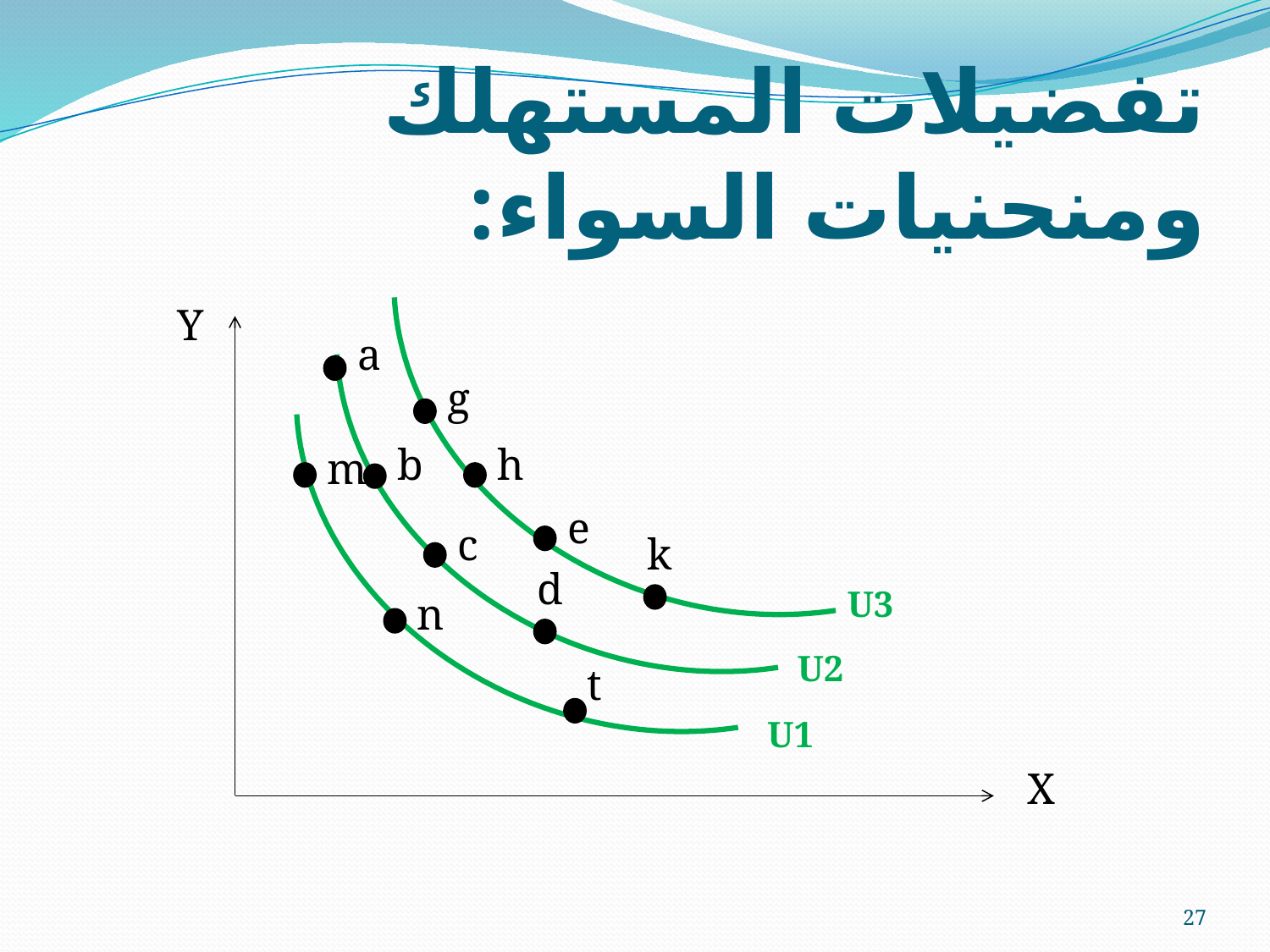
Do the curves rise or fall as X increases? fall How many labeled points are plotted on the chart? 11 What are the labels of the three curves on the chart? U1, U2, U3 Which curve does point t lie on? U1 Which curve does point k lie on? U3 Which curve lies farthest from the origin (highest on the chart)? U3 What is the label of the vertical axis? Y Which point has a higher Y value, point a or point n? a Which curve does point c lie on? U2 How many indifference curves are drawn on the chart? 3 What is the label of the horizontal axis? X Which curve lies closest to the origin (lowest on the chart)? U1